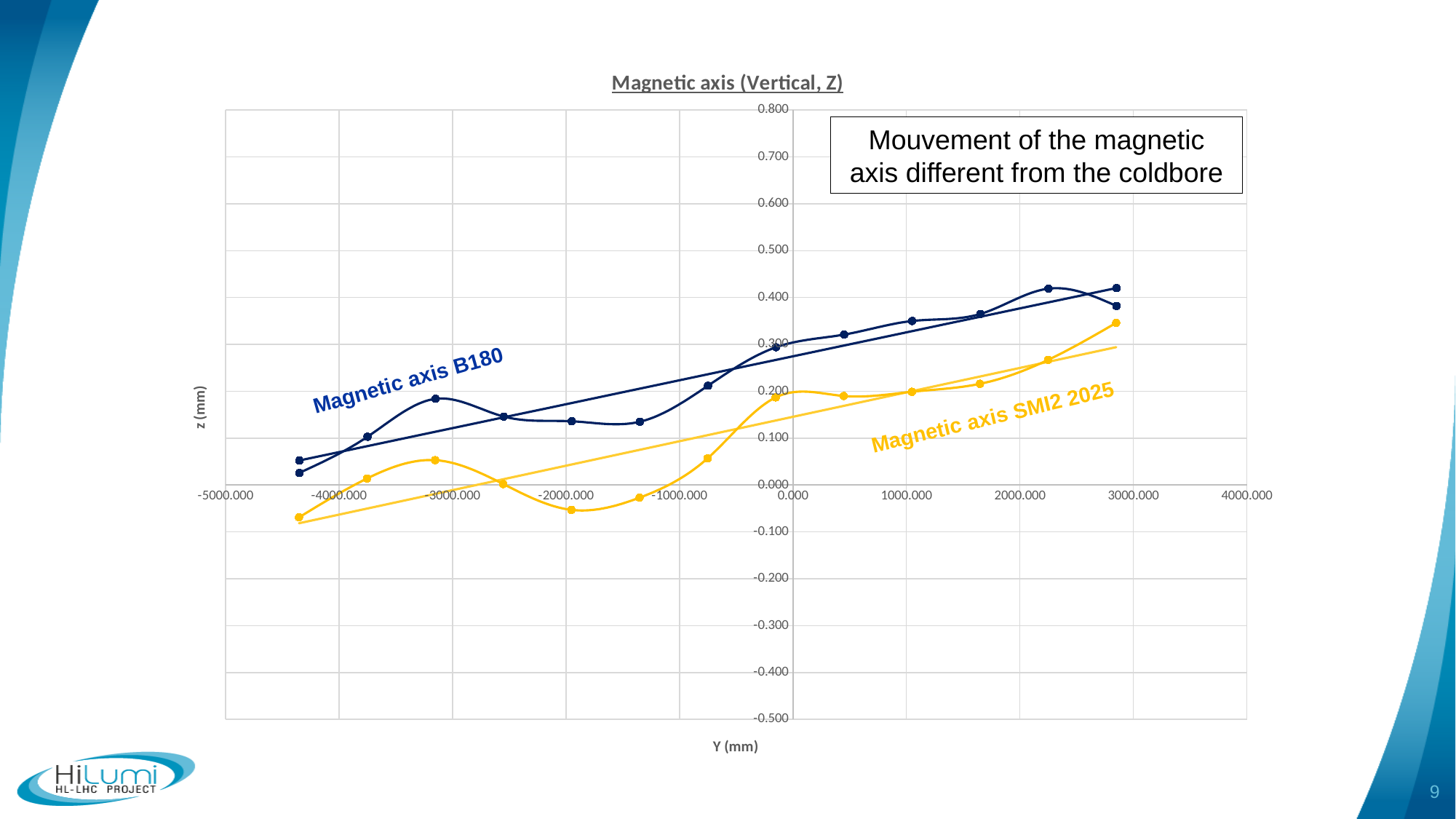
Do the values of the Magnetic axis B180 series generally rise or fall as Y increases? rise Which series is plotted in yellow? Magnetic axis SMI2 2025 What is the title of the chart? Magnetic axis (Vertical, Z) What kind of chart is shown on the slide? line chart At Y around 1000 mm, which series has the higher z value, Magnetic axis B180 or Magnetic axis SMI2 2025? Magnetic axis B180 Is the z value of the Magnetic axis B180 series at Y around -750 mm greater or less than 0.100? greater Do the values of the Magnetic axis SMI2 2025 series generally rise or fall as Y increases? rise What is the label of the horizontal axis of the chart? Y (mm) Is the z value of the Magnetic axis SMI2 2025 series at Y around 2850 mm greater or less than 0.300? greater Is the z value of the Magnetic axis B180 series at Y around 2250 mm greater or less than 0.300? greater How many data series are plotted on the chart? 4